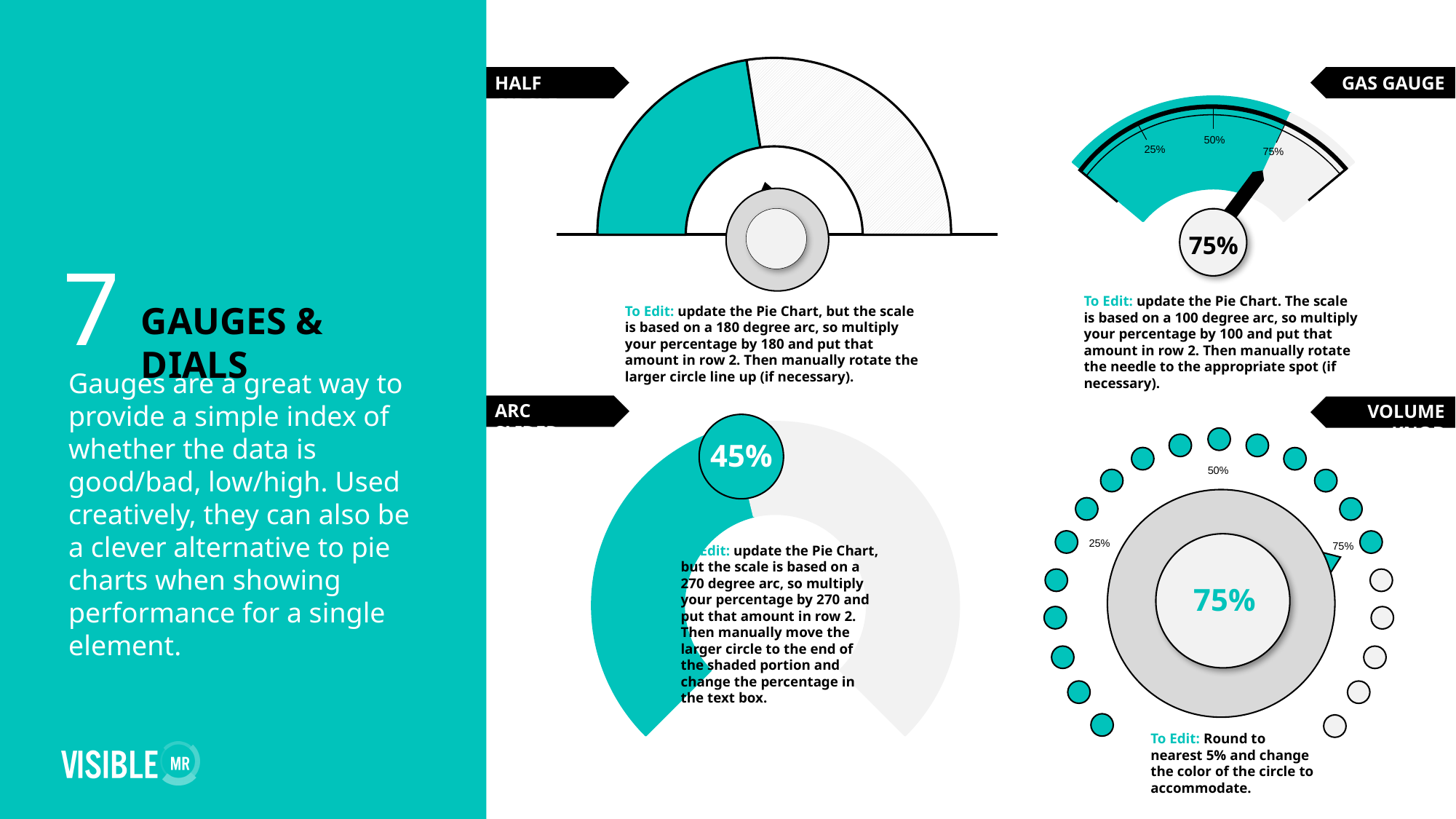
On the Gas Gauge chart, is the needle value greater or less than 50%? greater What tick labels are printed along the scale of the Gas Gauge chart? 25%, 50%, 75% Which shows a larger value, the Gas Gauge chart or the Arc Slider chart? Gas Gauge On the Arc Slider chart (bottom left), what percentage is shown in the circle at the end of the shaded arc? 45% What kind of chart is used throughout this slide? Gauge chart On the Volume Knob chart, how many small circles around the knob are white (unfilled)? 5 On the Gas Gauge chart (top right), what value does the needle indicate? 75% On the Volume Knob chart (bottom right), what percentage is printed in the centre of the knob? 75% On the Arc Slider chart, is the shaded value greater or less than 50%? less How many gauge charts are shown on the slide? 4 Of the three gauges with a printed value (Gas Gauge, Arc Slider, Volume Knob), which shows the lowest value? Arc Slider What is the difference between the value on the Gas Gauge chart (75%) and the value on the Arc Slider chart (45%)? 30%